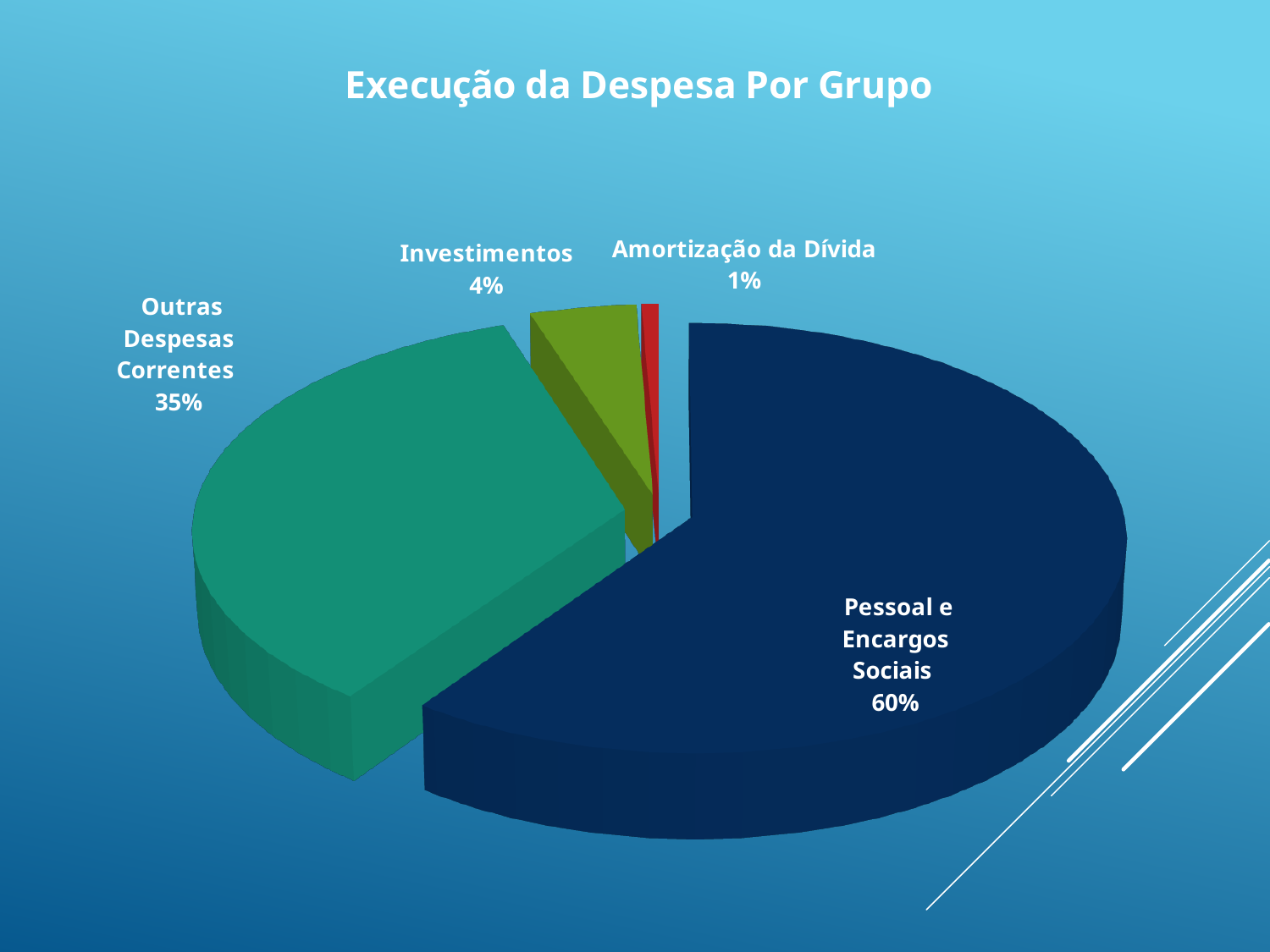
What is the value shown for Investimentos? 4% Which category has the smallest slice of the pie? Amortização da Dívida How many categories are shown in the pie chart? 4 What is the value shown for Amortização da Dívida? 1% What is the title of the chart? Execução da Despesa Por Grupo What kind of chart is shown on the slide? Pie chart What is the difference in percentage points between Pessoal e Encargos Sociais and Outras Despesas Correntes? 25 percentage points Which is larger, Investimentos or Amortização da Dívida? Investimentos What share of the pie does Outras Despesas Correntes represent? 35% Which category has the largest slice of the pie? Pessoal e Encargos Sociais What colour is the slice for Pessoal e Encargos Sociais? Dark blue What share of the pie does Pessoal e Encargos Sociais represent? 60%